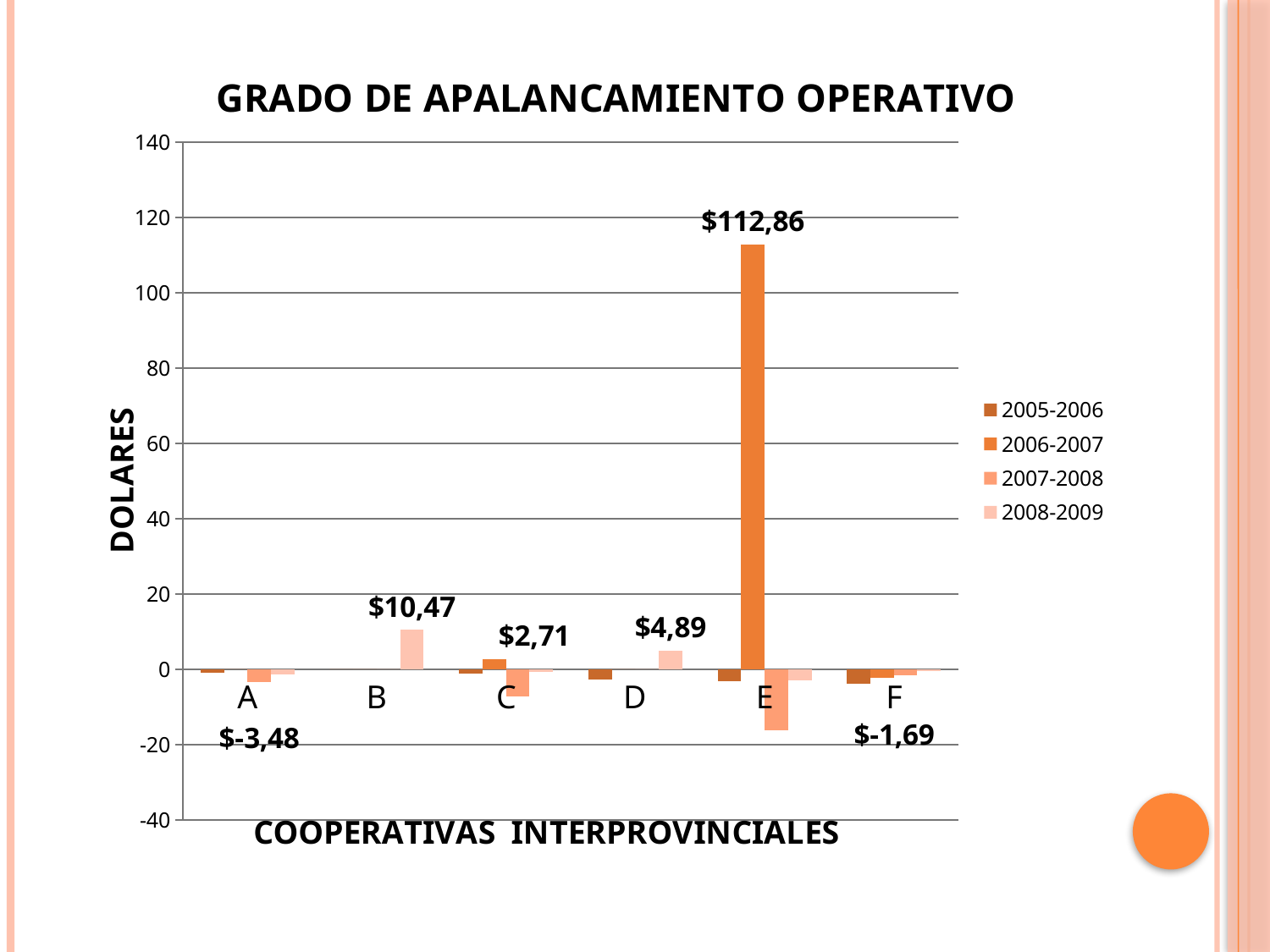
How many cooperatives (categories) are shown on the x axis? 6 What type of chart is shown on the slide? bar chart What is the difference between the labelled value for cooperative B ($10,47) and the labelled value for cooperative D ($4,89)? $5,58 What is the value of the 2006-2007 bar for cooperative E? $112,86 What is the title of the chart? GRADO DE APALANCAMIENTO OPERATIVO Is the 2006-2007 value for cooperative E greater or less than 100? greater Which cooperative has the highest bar in the chart? E What is the labelled value shown for cooperative A? $-3,48 How many series does the legend list? 4 What is the labelled value shown for cooperative B? $10,47 What is the labelled value shown for cooperative F? $-1,69 Which is larger, the labelled value for cooperative B or the labelled value for cooperative D? B